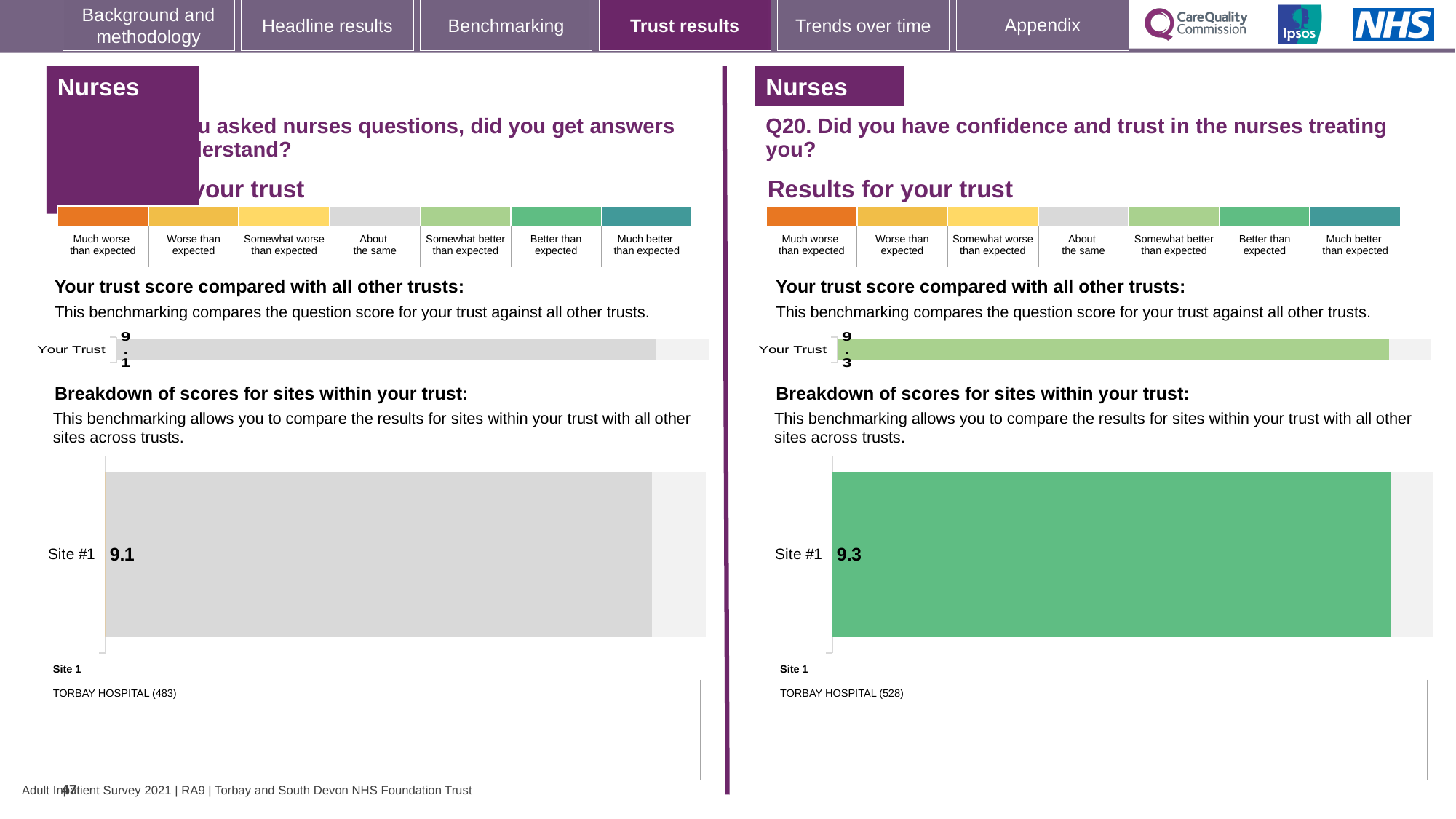
In the right-hand 'Breakdown of scores for sites within your trust' chart (Q20), what is the score for Site #1? 9.3 How many sites are shown in the left-hand 'Breakdown of scores for sites within your trust' chart? 1 On the right-hand side (Q20), what is the trust score shown for 'Your Trust'? 9.3 What colour is the Site #1 bar in the left-hand breakdown chart? Grey In the left-hand 'Breakdown of scores for sites within your trust' chart, what is the score for Site #1? 9.1 What type of chart is used to show the Site #1 score in the right-hand (Q20) breakdown section? Bar chart Which site name is listed as Site 1 beneath the right-hand (Q20) breakdown chart? TORBAY HOSPITAL (528) How many sites are shown in the right-hand (Q20) 'Breakdown of scores for sites within your trust' chart? 1 What is the difference between the Site #1 score in the right-hand (Q20) breakdown chart and the Site #1 score in the left-hand breakdown chart? 0.2 On the left-hand side of the slide, what is the trust score shown for 'Your Trust'? 9.1 What colour is the Site #1 bar in the right-hand (Q20) breakdown chart? Green Which is larger: the Site #1 score in the left-hand breakdown chart or the Site #1 score in the right-hand (Q20) breakdown chart? The right-hand (Q20) chart